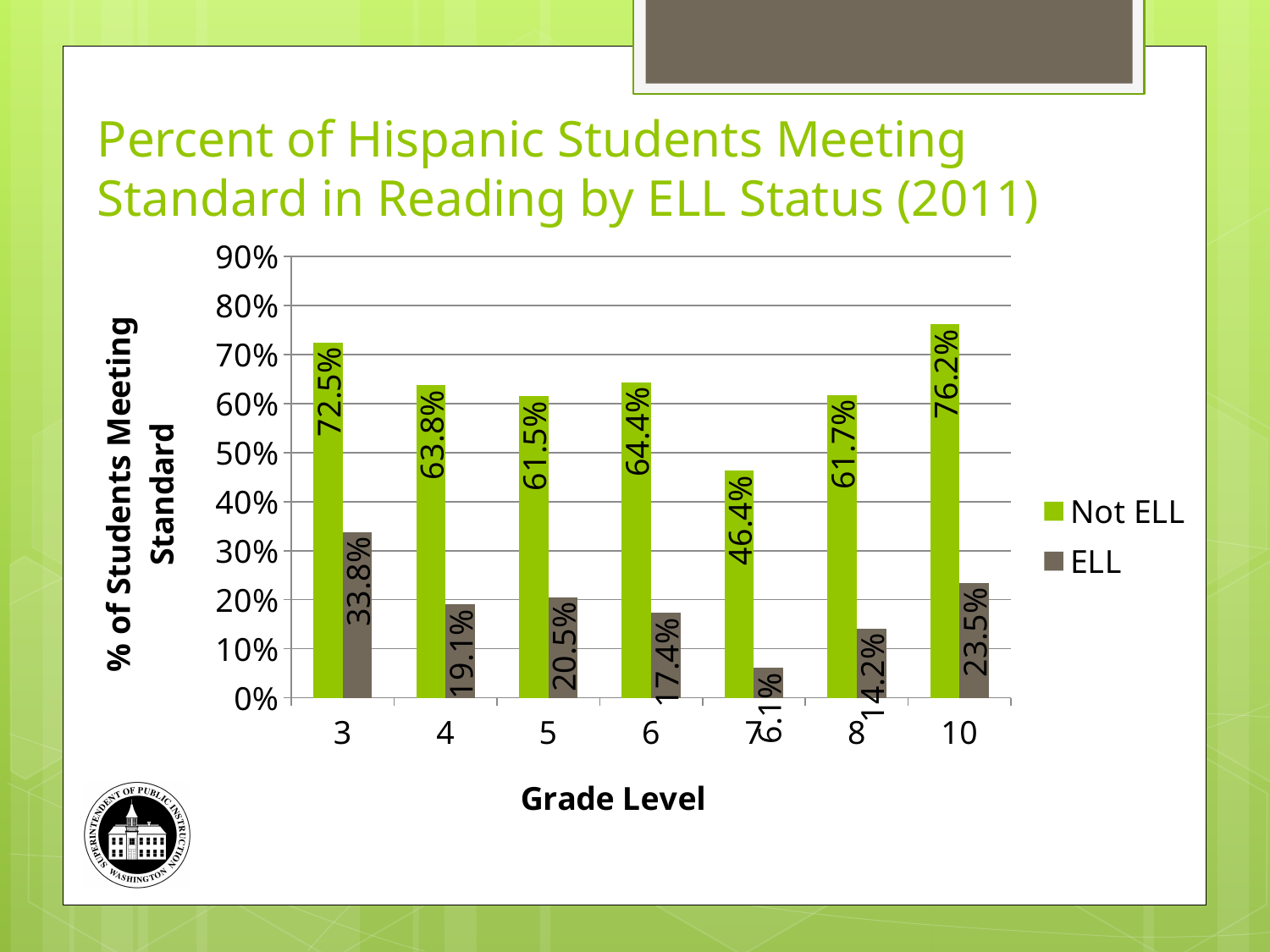
At which grade level is the Not ELL percentage highest? 10 Which is larger at grade 4: the Not ELL value or the ELL value? Not ELL How many series does the legend list? 2 How many grade levels are shown on the x axis? 7 What is the difference between the Not ELL and ELL values at grade 7? 40.3% What is the label of the y axis? % of Students Meeting Standard What is the value for Not ELL students at grade 10? 76.2% What kind of chart is shown on the slide? Bar chart Is the ELL value at grade 3 greater or less than 30%? greater What is the value for ELL students at grade 5? 20.5% What percentage of Not ELL Hispanic students met standard in reading at grade 3? 72.5% At which grade level is the ELL percentage lowest? 7